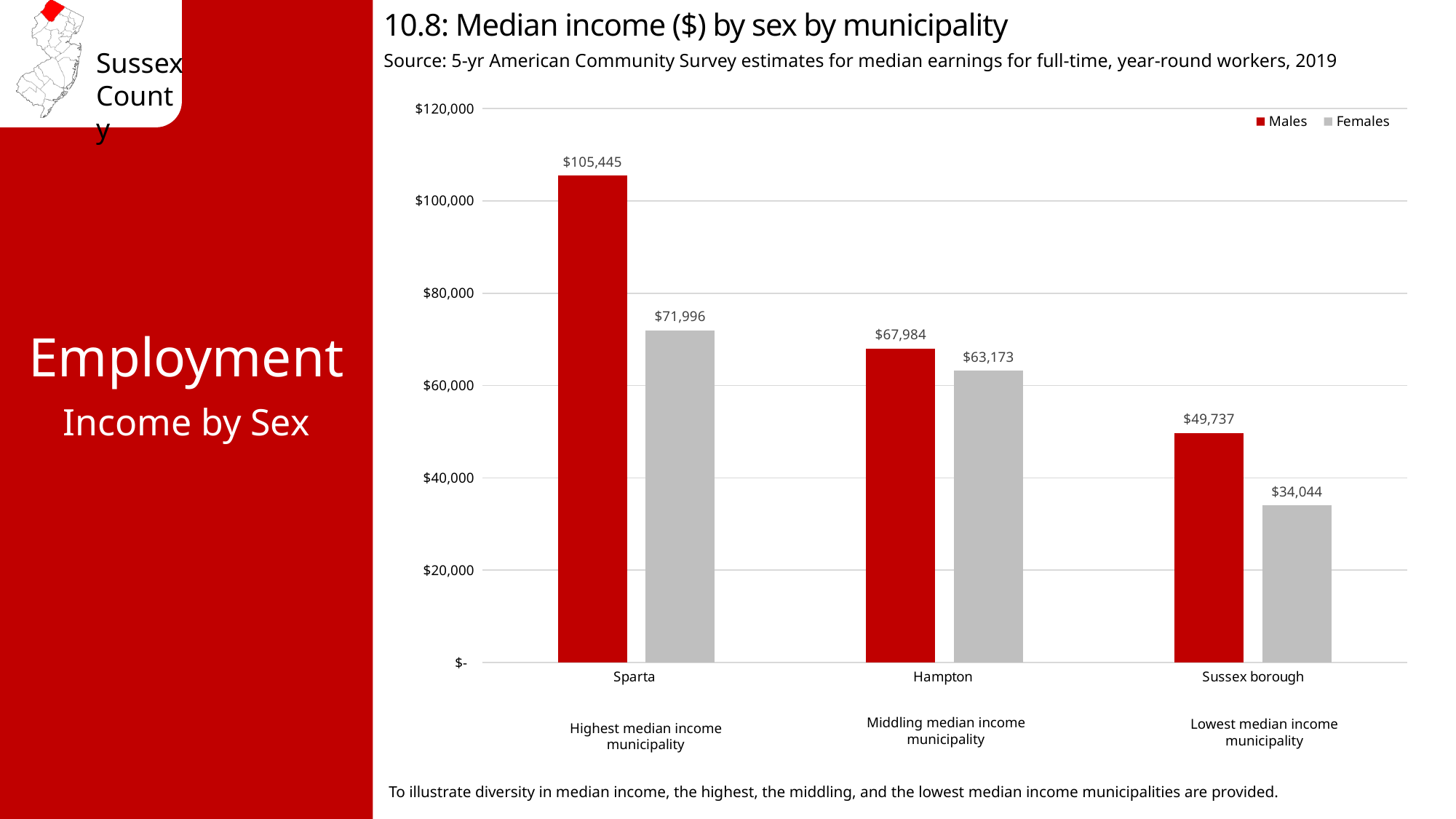
What is the difference between male and female median income in Sparta? $33,449 Which colour represents Males in the chart? Red What kind of chart is shown on the slide? Bar chart What is the median income for females in Hampton? $63,173 Which municipality has the lowest median income for females? Sussex borough What is the median income for males in Sparta? $105,445 What is the difference between male and female median income in Sussex borough? $15,693 How many series does the legend list? 2 Which municipality has the highest median income for males? Sparta Which is larger: the female median income in Sparta or the male median income in Hampton? Female median income in Sparta How many municipalities are shown on the chart? 3 What is the median income for females in Sussex borough? $34,044